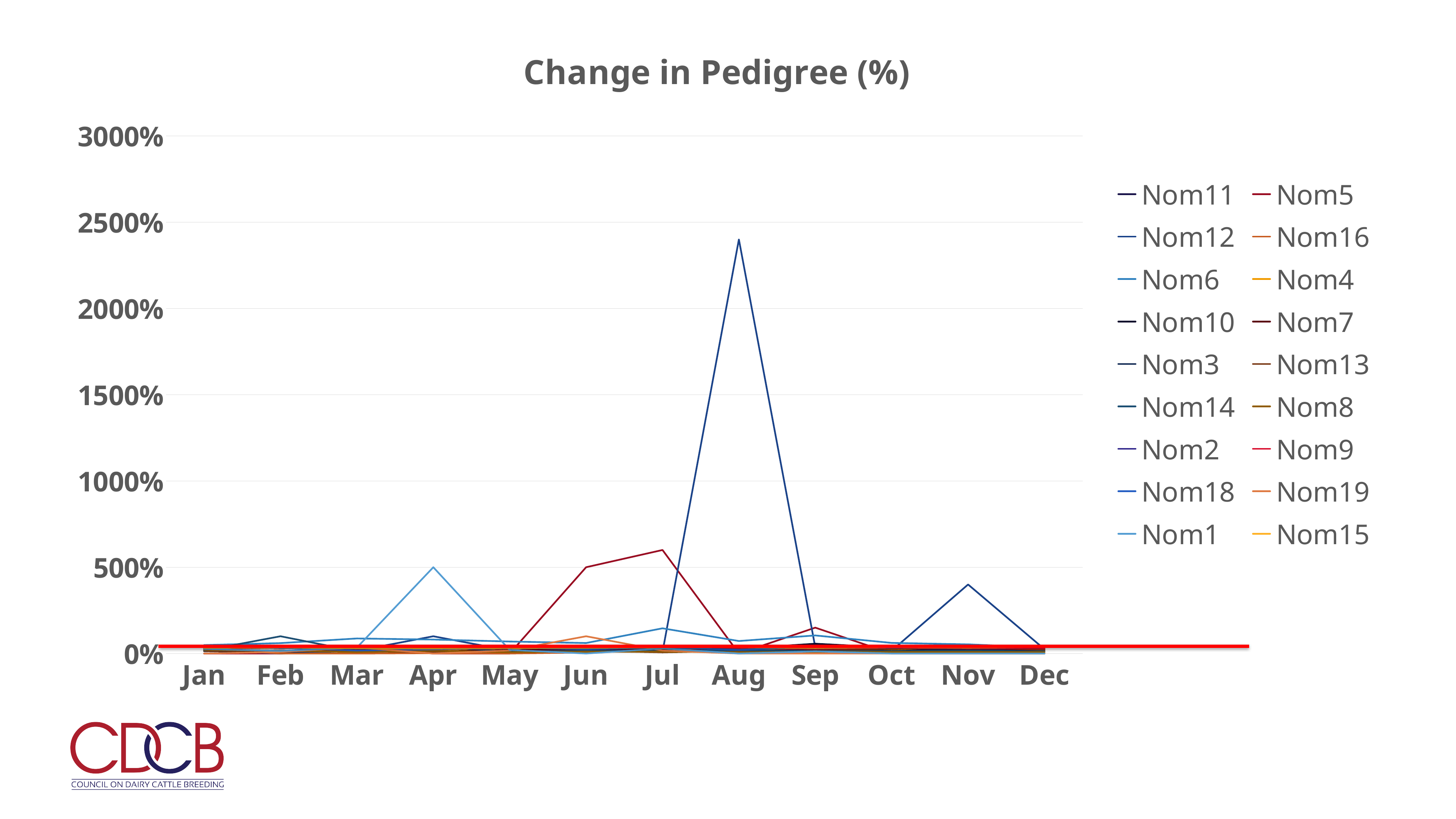
Is the highest peak in Aug greater or less than 2500%? less Is the peak of the dark red line in Jul greater or less than 1000%? less How many months are shown on the x axis? 12 Is the peak of the dark blue line in Nov greater or less than 500%? less Which is larger: the peak in Aug or the peak in Apr? the peak in Aug How many series does the legend list? 18 In which month does the highest peak on the chart occur? Aug What is the title of the chart? Change in Pedigree (%) What kind of chart is shown on the slide? line chart What is the highest value shown on the y axis? 3000% Which is larger: the peak in Jul or the peak in Nov? the peak in Jul